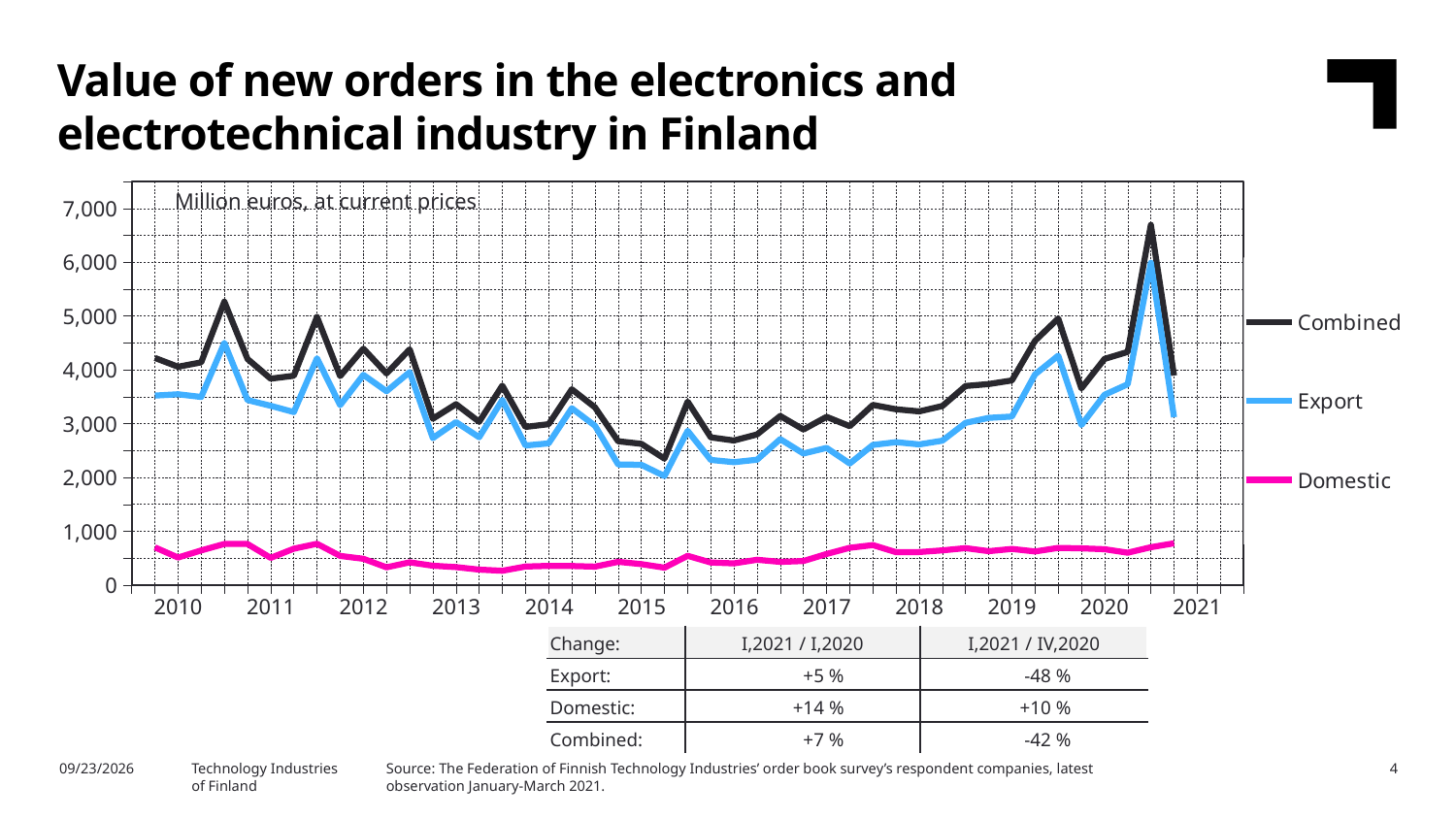
Which series is plotted with the highest values throughout the chart? Combined Do the Combined values generally rise or fall between 2012 and 2015? fall Is the value for Domestic in 2015 greater or less than 1,000? less What kind of chart is shown on the slide? Line chart What colour is the Domestic line in the chart? Pink Which series is higher in 2018, Export or Domestic? Export Is the peak value of the Combined series in 2020 greater or less than 6,000? greater How many series does the legend list? 3 What unit is stated for the values in the chart? Million euros, at current prices Is the value for Export at the start of 2016 greater or less than 3,000? less Which series is plotted with the lowest values throughout the chart? Domestic Do the Export values generally rise or fall between 2016 and 2019? rise